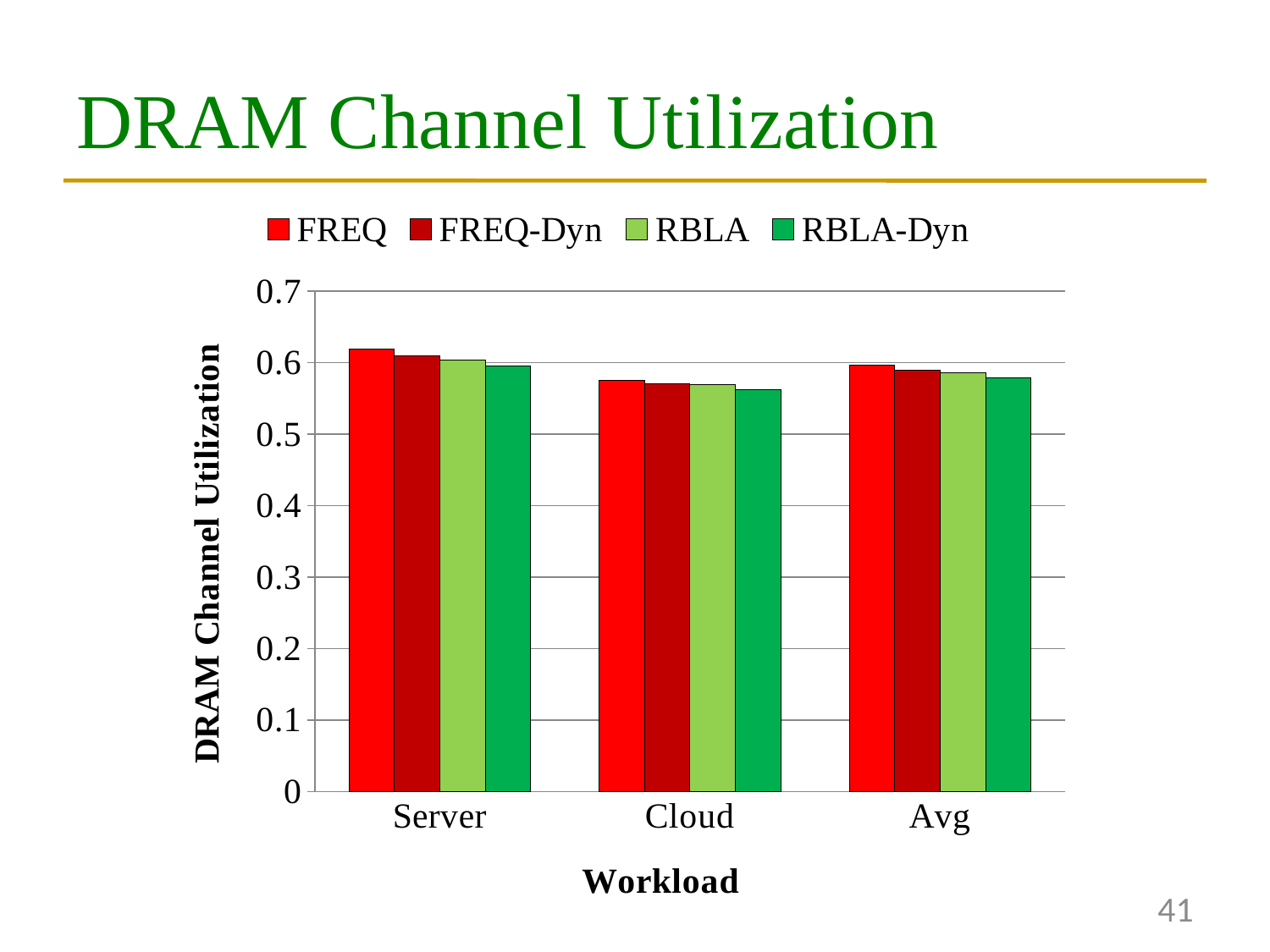
What is the title of the y axis? DRAM Channel Utilization What is the title of the x axis? Workload Is the RBLA-Dyn value for Cloud greater or less than 0.5? greater Which is larger for the Server workload, the FREQ bar or the RBLA-Dyn bar? FREQ Which workload has the highest DRAM channel utilization for the FREQ series? Server Which is larger, the FREQ value for Server or the FREQ value for Cloud? Server How many workload categories are shown on the x axis? 3 Is the FREQ value for Cloud greater or less than 0.6? less Which workload has the lowest DRAM channel utilization for the RBLA-Dyn series? Cloud What kind of chart is shown on the slide? bar chart How many series does the legend list? 4 Is the FREQ value for Server greater or less than 0.6? greater